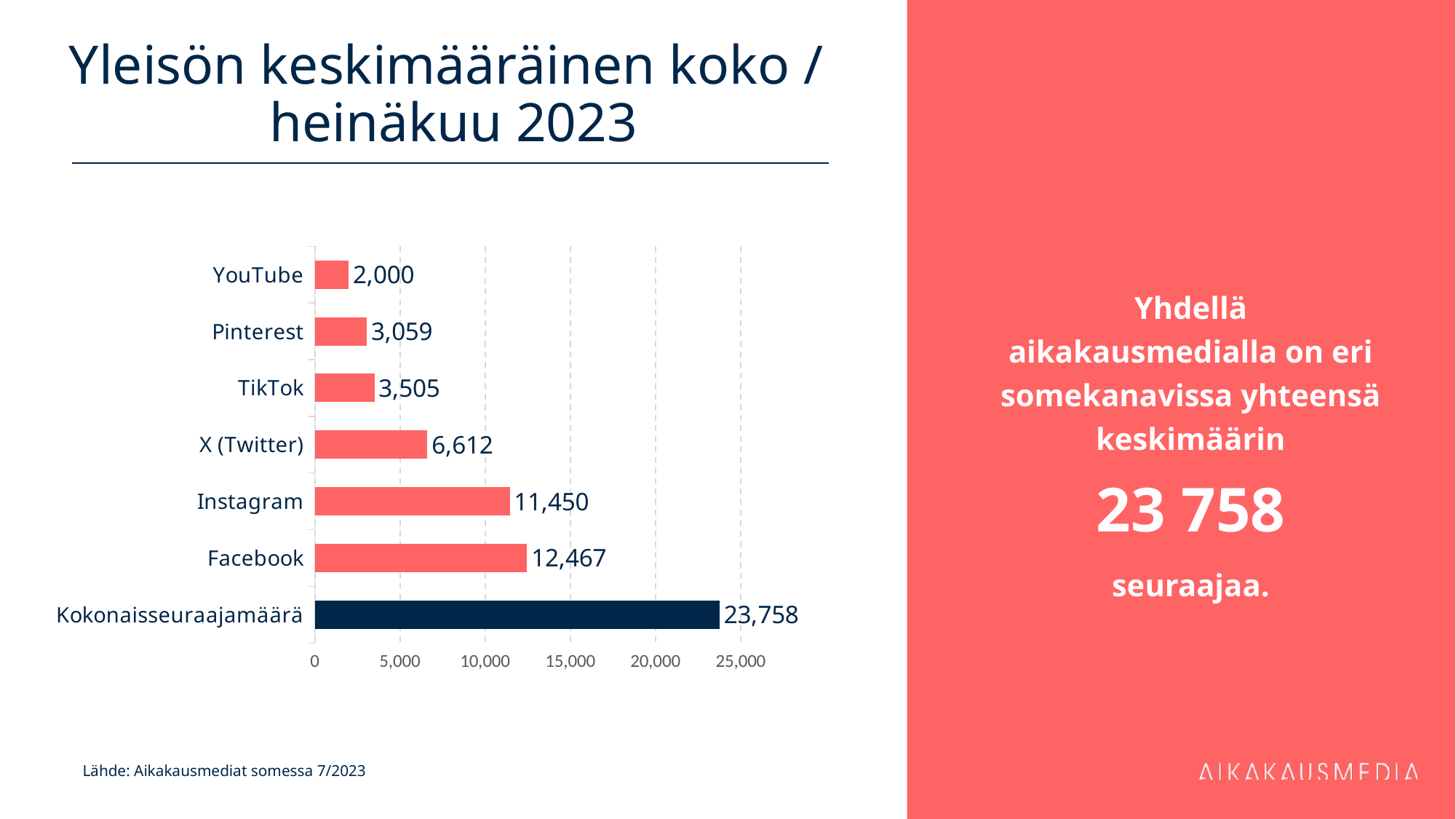
What is the value for Kokonaisseuraajamäärä? 23,758 What is the value for X (Twitter)? 6,612 Which category has the lowest value? YouTube What is the title of the slide containing the chart? Yleisön keskimääräinen koko / heinäkuu 2023 What is the difference between the values for TikTok and Pinterest? 446 How many categories are shown in the chart? 7 What is the value for Instagram? 11,450 What is the difference between the values for Facebook and Instagram? 1,017 Which platform (excluding Kokonaisseuraajamäärä) has the highest value? Facebook Which is larger, the value for TikTok or the value for Pinterest? TikTok What kind of chart is shown on the slide? bar chart Is the value for X (Twitter) greater or less than 5,000? greater